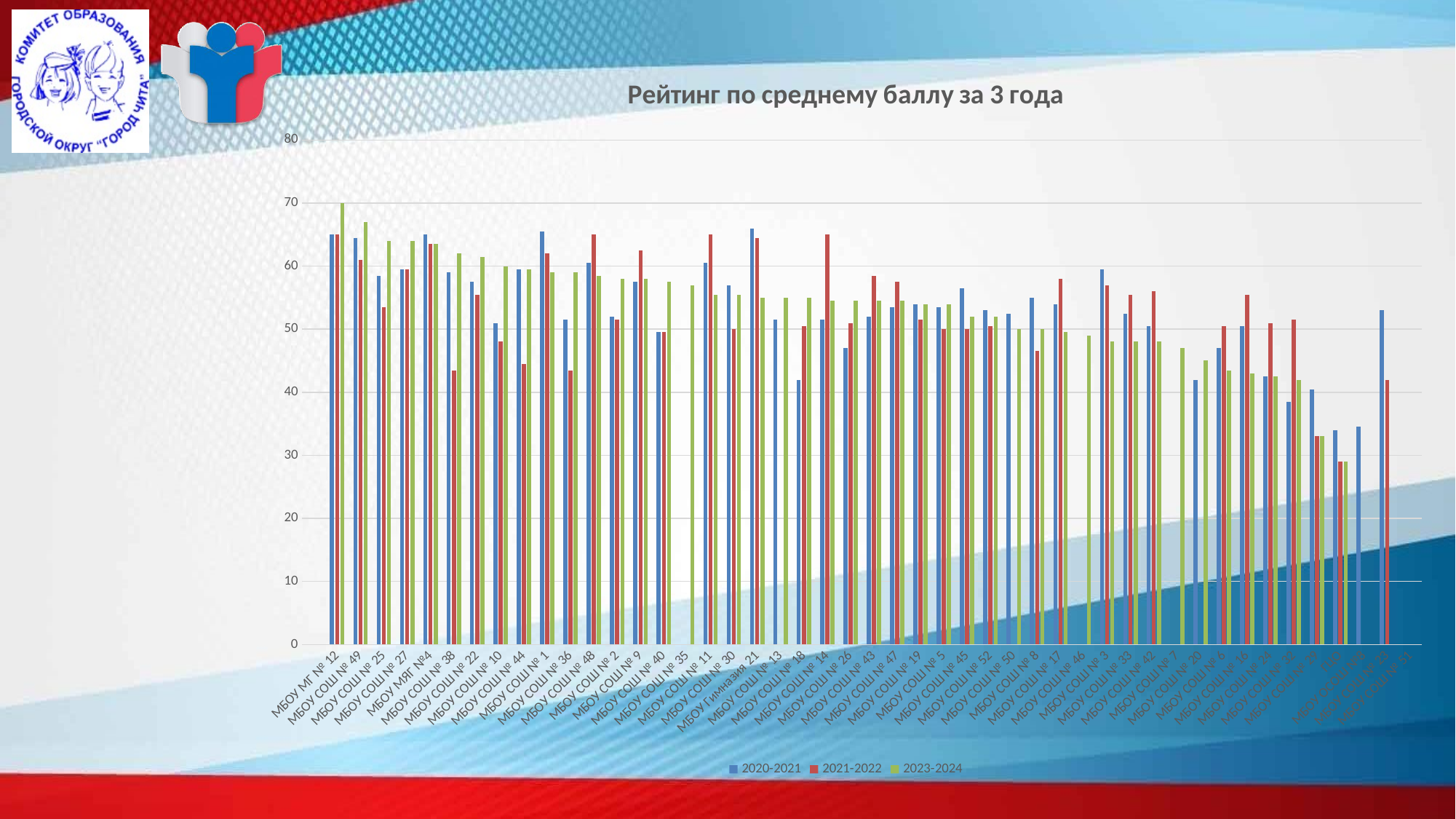
Which category has the highest 2023-2024 value? МБОУ МГ № 12 How many series does the legend list? 3 Is the 2021-2022 value for МБОУ СОШ № 14 greater or less than 60? greater Is the 2021-2022 value for МБОУ СОШ № 38 greater or less than 50? less Is the 2023-2024 value for МБОУ СОШ № 49 greater or less than 60? greater Do the 2020-2021 values generally rise or fall from left to right along the x axis? fall For МБОУ СОШ № 38, which is larger: the 2020-2021 value or the 2021-2022 value? 2020-2021 What kind of chart is shown on the slide? bar chart For МБОУ СОШ № 16, which is larger: the 2021-2022 value or the 2023-2024 value? 2021-2022 Which series is shown in green in the legend? 2023-2024 What is the title of the chart? Рейтинг по среднему баллу за 3 года